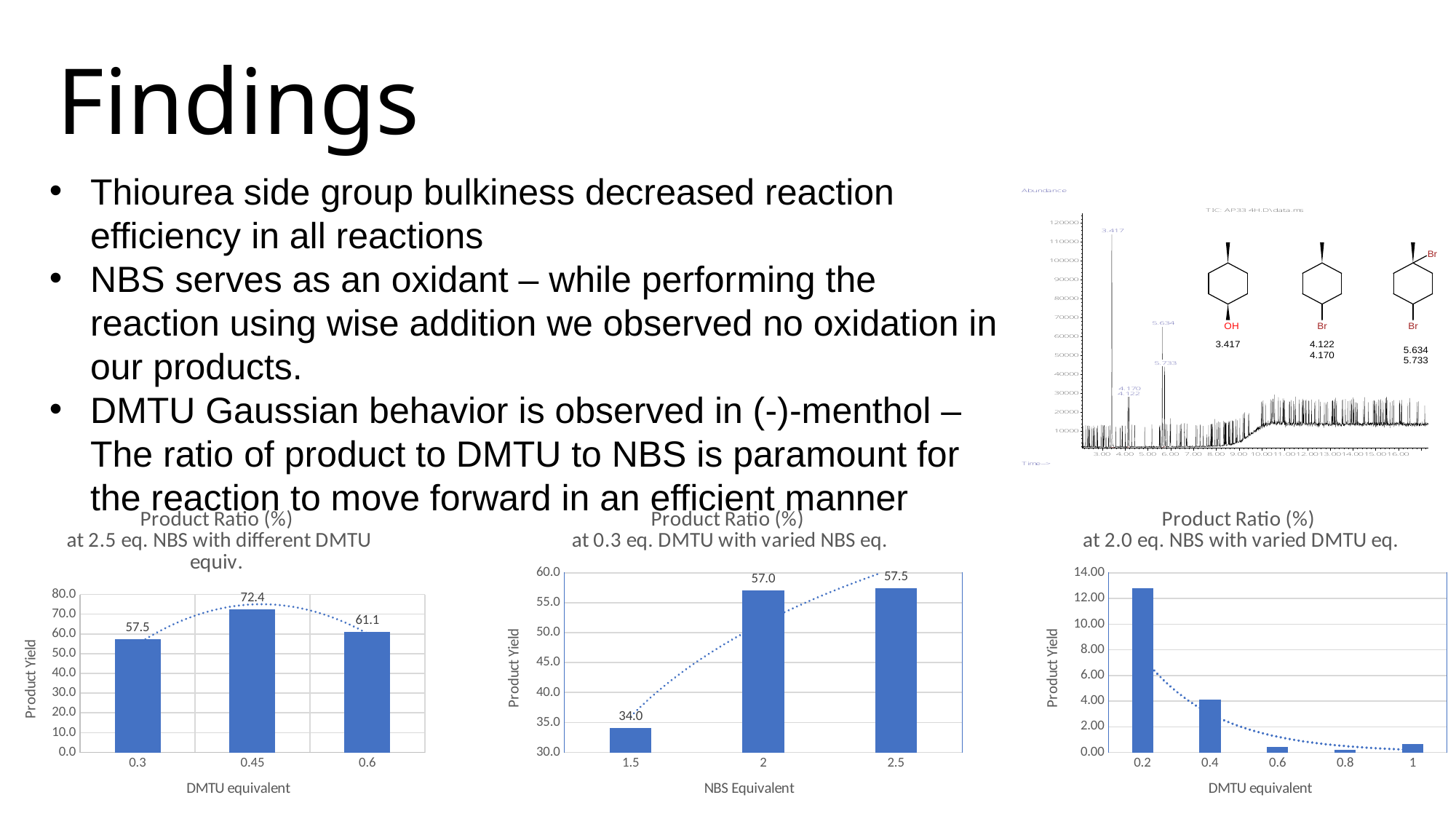
In the right chart (at 2.0 eq. NBS with varied DMTU eq.), which DMTU equivalent gives the highest product yield? 0.2 In the middle chart (at 0.3 eq. DMTU with varied NBS eq.), what is the difference in product yield between 2 and 1.5 NBS equivalent? 23.0 In the left chart (at 2.5 eq. NBS with different DMTU equiv.), what is the difference in product yield between 0.45 and 0.3 DMTU equivalent? 14.9 In the left chart (at 2.5 eq. NBS with different DMTU equiv.), what is the product yield at 0.45 DMTU equivalent? 72.4 In the right chart (at 2.0 eq. NBS with varied DMTU eq.), is the product yield at 0.2 DMTU equivalent greater or less than 12.00? greater What type of chart is the right chart (at 2.0 eq. NBS with varied DMTU eq.)? bar chart In the left chart (at 2.5 eq. NBS with different DMTU equiv.), how many DMTU equivalent categories are plotted? 3 In the right chart (at 2.0 eq. NBS with varied DMTU eq.), how many DMTU equivalent categories are plotted? 5 In the left chart (at 2.5 eq. NBS with different DMTU equiv.), which DMTU equivalent gives the highest product yield? 0.45 In the middle chart (at 0.3 eq. DMTU with varied NBS eq.), what is the product yield at 1.5 NBS equivalent? 34.0 In the middle chart (at 0.3 eq. DMTU with varied NBS eq.), do the product yields rise or fall as NBS equivalent increases? rise In the middle chart (at 0.3 eq. DMTU with varied NBS eq.), which NBS equivalent gives the lowest product yield? 1.5